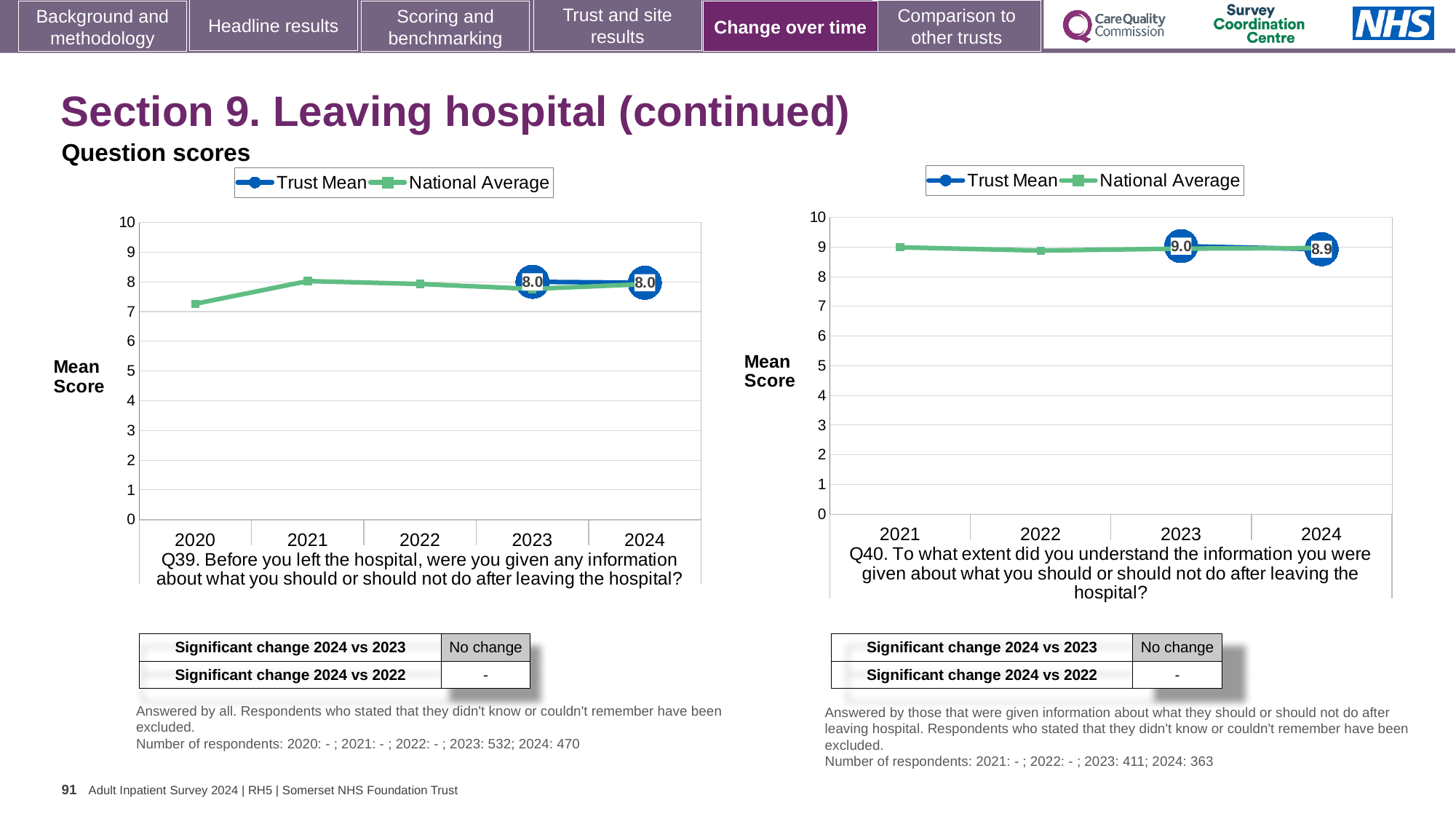
What kind of chart is the Q40 chart on the right? Line chart In the Q40 chart on the right, what is the Trust Mean score for 2023? 9.0 In the Q40 chart on the right, what is the Trust Mean score for 2024? 8.9 In the Q39 chart on the left, what is the Trust Mean score for 2024? 8.0 How many series does the legend of the Q39 chart on the left list? 2 How many years are shown on the x axis of the Q40 chart on the right? 4 In the Q40 chart on the right, what is the difference between the Trust Mean scores for 2023 and 2024? 0.1 How many years are shown on the x axis of the Q39 chart on the left? 5 In the Q39 chart on the left, is the National Average for 2020 greater or less than 8? less In the Q40 chart on the right, which year has the higher Trust Mean score, 2023 or 2024? 2023 In the Q39 chart on the left, what is the Trust Mean score for 2023? 8.0 In the Q40 chart on the right, is the National Average for 2021 greater or less than 8? greater